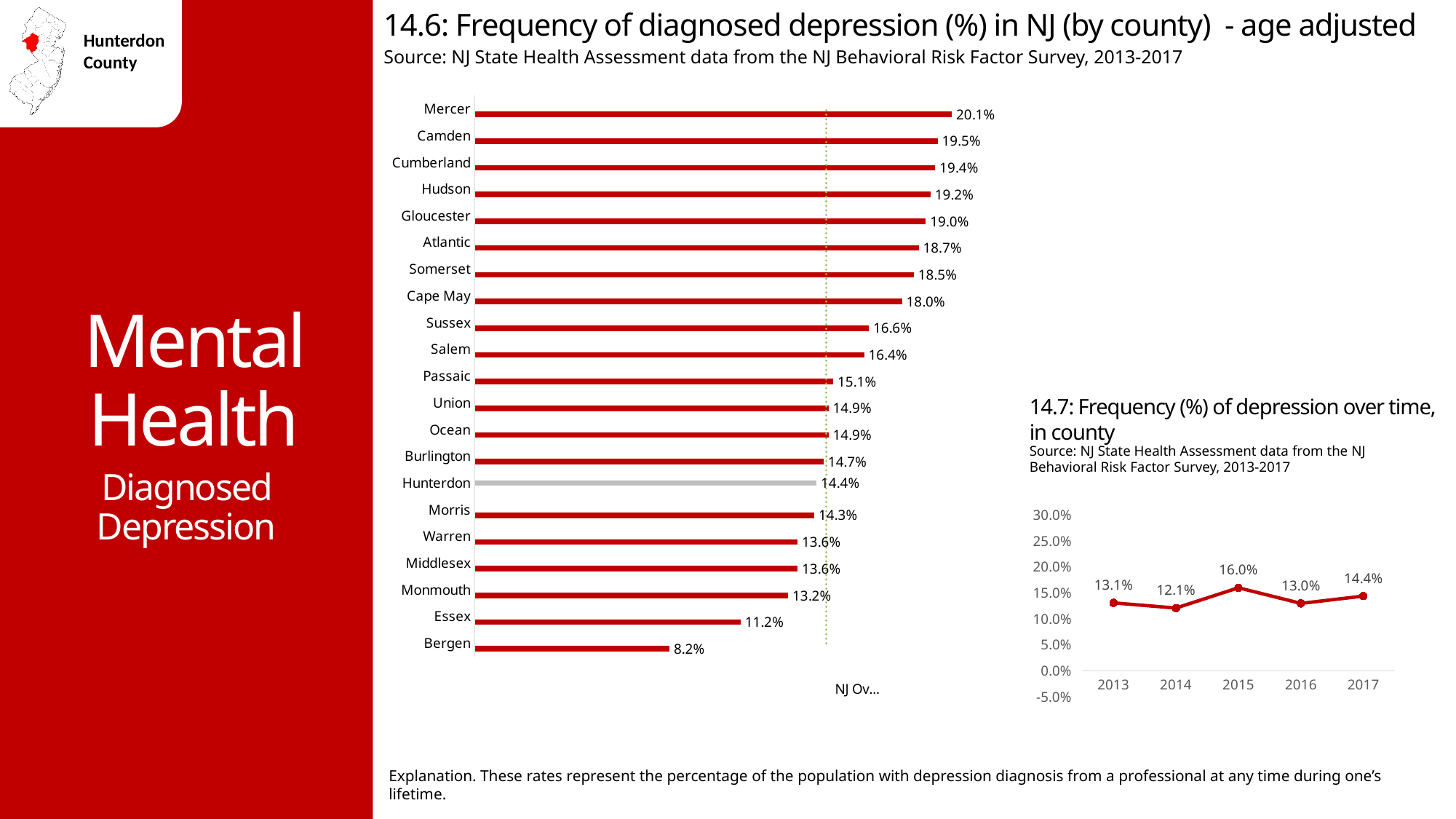
In chart 14.6 (frequency of diagnosed depression by county), how many counties are shown? 21 In chart 14.6 (frequency of diagnosed depression by county), what is the value for Essex? 11.2% In chart 14.7 (frequency of depression over time in county), what is the value for 2015? 16.0% In chart 14.6 (frequency of diagnosed depression by county), which county has the lowest value? Bergen What kind of chart is chart 14.6 (frequency of diagnosed depression by county)? Bar chart In chart 14.7 (frequency of depression over time in county), which year has the lowest value? 2014 In chart 14.6 (frequency of diagnosed depression by county), what is the difference between Mercer and Bergen? 11.9% In chart 14.7 (frequency of depression over time in county), what is the difference between the 2015 and 2014 values? 3.9% In chart 14.7 (frequency of depression over time in county), how many years are plotted? 5 In chart 14.6 (frequency of diagnosed depression by county), which is larger, the value for Sussex or the value for Salem? Sussex In chart 14.6 (frequency of diagnosed depression by county), which county has the highest value? Mercer In chart 14.6 (frequency of diagnosed depression by county), what is the value for Hunterdon? 14.4%